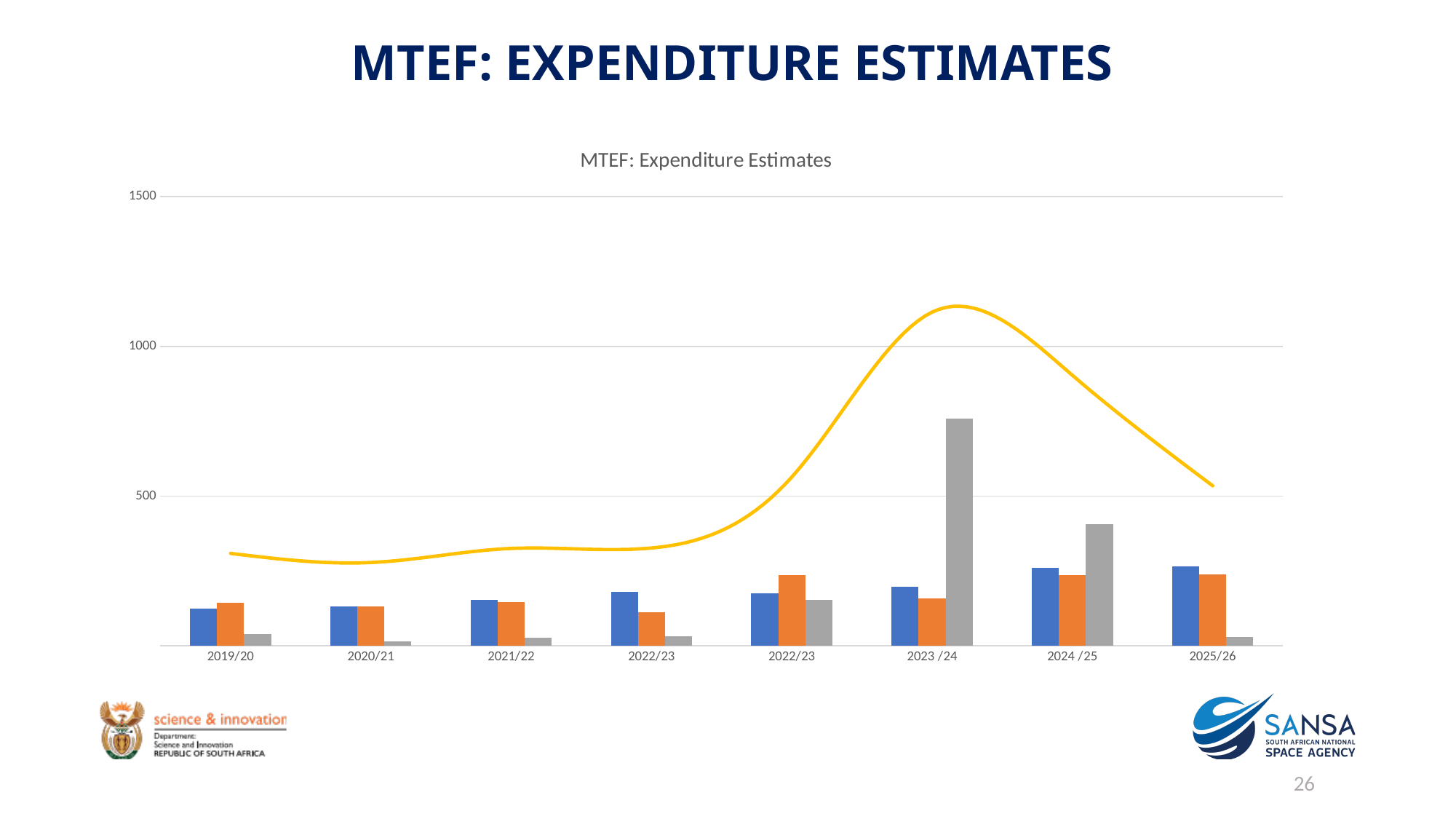
Is the value of the grey bar for 2023 /24 greater or less than 500? greater Is the peak value of the yellow line at 2023 /24 greater or less than 1000? greater What kind of chart is shown on the slide? A combination bar and line chart In which category does the grey bar reach its highest value? 2023 /24 In which category does the yellow line reach its highest point? 2023 /24 How many bars are plotted for each category on the chart? 3 How many categories are shown along the x axis of the chart? 8 Which is larger, the grey bar for 2023 /24 or the grey bar for 2024 /25? 2023 /24 Is the value of the yellow line at 2019/20 greater or less than 500? less Does the yellow line rise or fall from 2023 /24 to 2025/26? Falls What is the title of the chart? MTEF: Expenditure Estimates